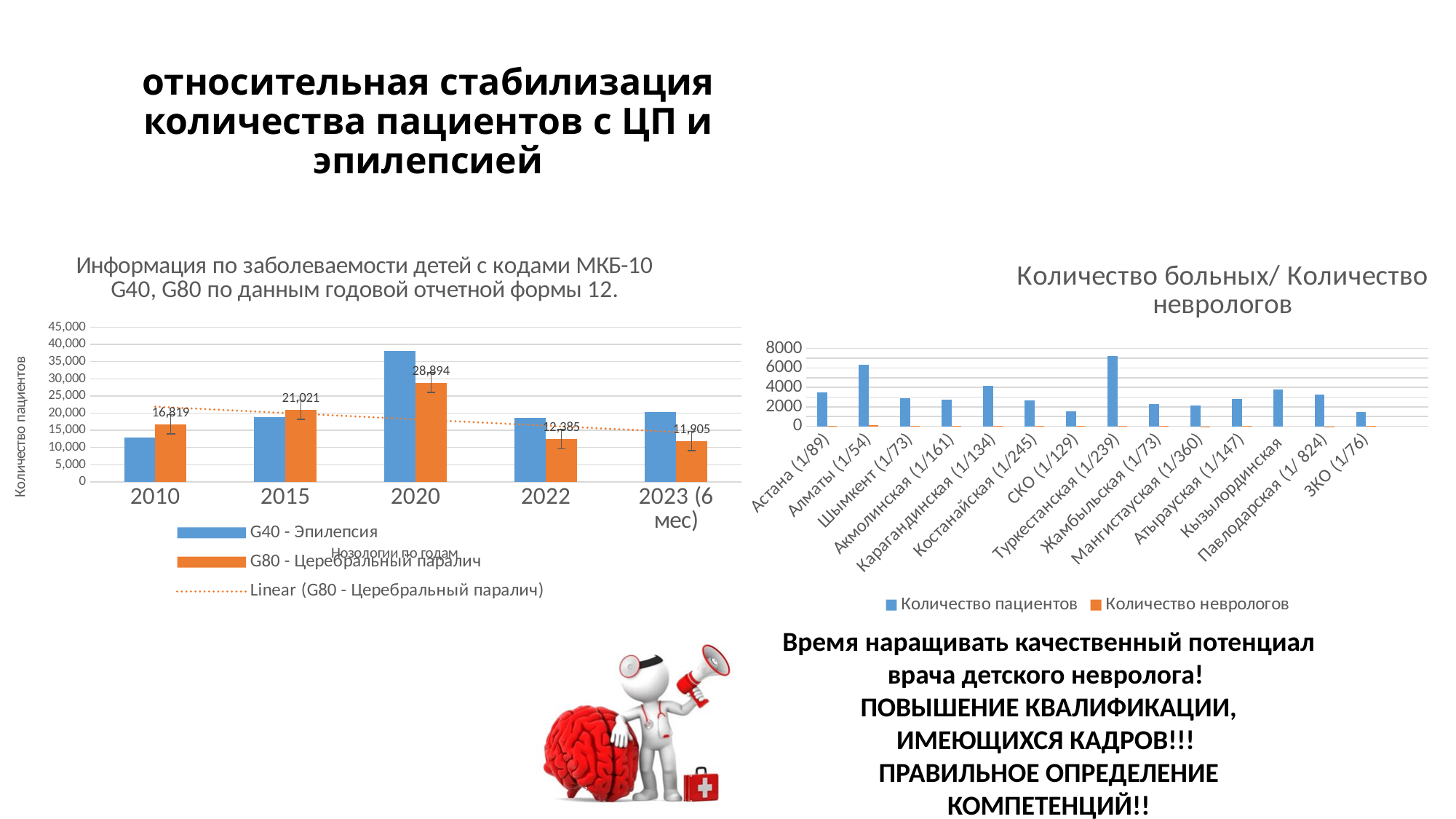
In the left chart (Информация по заболеваемости детей...), how many entries does the legend list? 3 In the left chart (Информация по заболеваемости детей...), in which period is the G80 - Церебральный паралич value lowest? 2023 (6 мес) In the right chart (Количество больных/ Количество неврологов), is the Количество пациентов for Алматы (1/54) greater or less than 4000? greater In the right chart (Количество больных/ Количество неврологов), which has the larger Количество пациентов: Астана (1/89) or Шымкент (1/73)? Астана (1/89) In the left chart (Информация по заболеваемости детей...), is the value for G40 - Эпилепсия in 2020 greater or less than 35,000? greater In the left chart (Информация по заболеваемости детей...), what is the value for G80 - Церебральный паралич in 2020? 28,894 In the left chart (Информация по заболеваемости детей...), how many year categories are shown on the x axis? 5 In the left chart (Информация по заболеваемости детей...), what is the difference between the G80 - Церебральный паралич values for 2015 and 2022? 8,636 In the left chart (Информация по заболеваемости детей...), in which year is the G80 - Церебральный паралич value highest? 2020 In the left chart (Информация по заболеваемости детей...), what is the value for G80 - Церебральный паралич in 2010? 16,819 In the right chart (Количество больных/ Количество неврологов), which region has the highest Количество пациентов? Туркестанская (1/239) In the right chart (Количество больных/ Количество неврологов), how many regions are shown on the x axis? 14